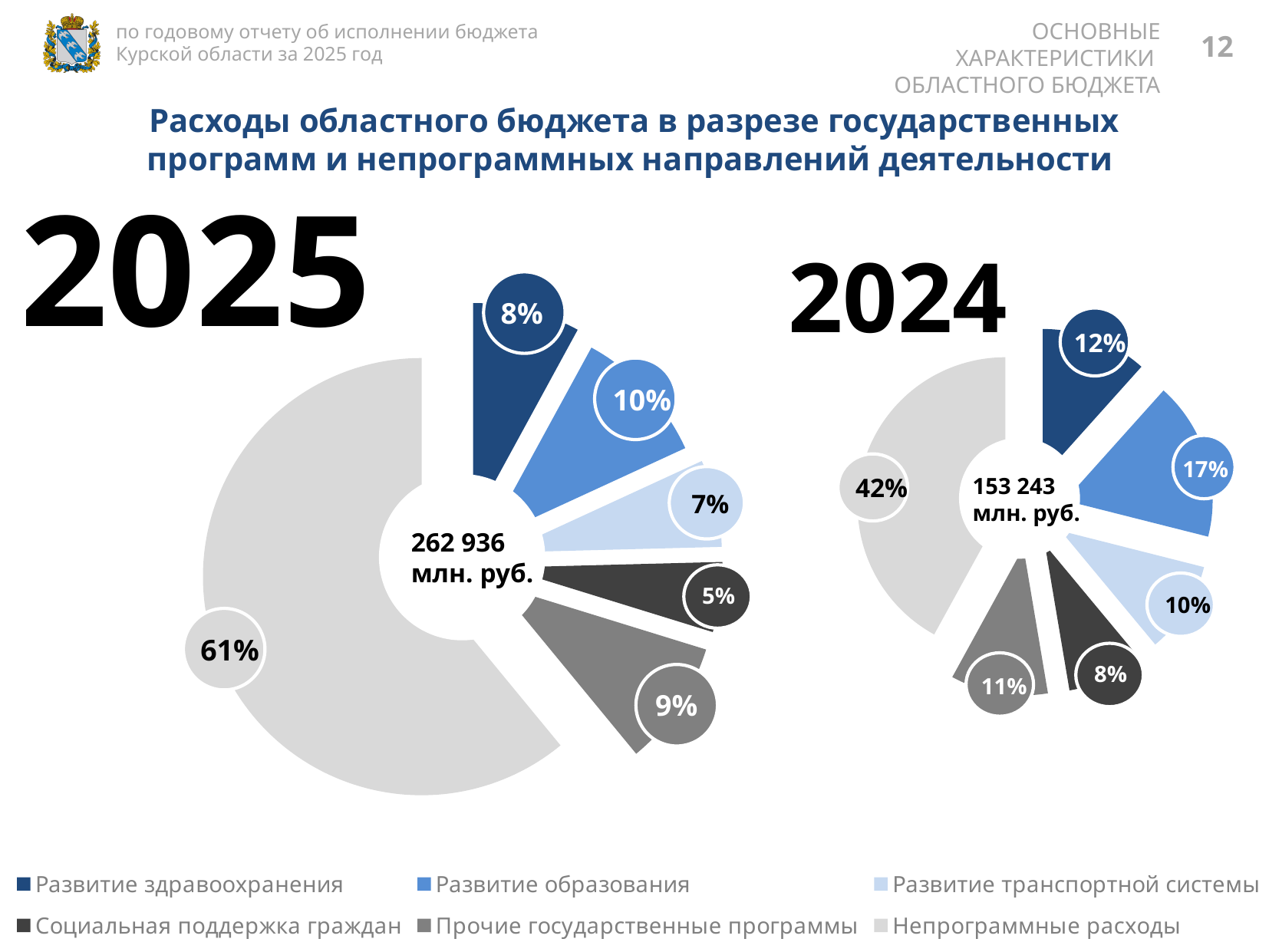
Какая общая сумма расходов указана в центре диаграммы 2024? 153 243 млн. руб. Что больше: доля «Развитие транспортной системы» на диаграмме 2025 или на диаграмме 2024? 2024 На диаграмме 2024 какая категория имеет наименьшую долю? Социальная поддержка граждан На диаграмме 2024 какая доля приходится на «Развитие здравоохранения»? 12% На диаграмме 2025 какая доля приходится на «Непрограммные расходы»? 61% На диаграмме 2024 какая доля приходится на «Развитие образования»? 17% На диаграмме 2025 какая доля приходится на «Социальная поддержка граждан»? 5% На сколько процентных пунктов доля «Развитие образования» в 2024 году больше, чем в 2025 году? 7 На диаграмме 2025 какая категория имеет наибольшую долю? Непрограммные расходы Сколько категорий перечислено в легенде диаграмм? 6 Какая общая сумма расходов указана в центре диаграммы 2025? 262 936 млн. руб. На диаграмме 2025 какая категория имеет наименьшую долю? Социальная поддержка граждан